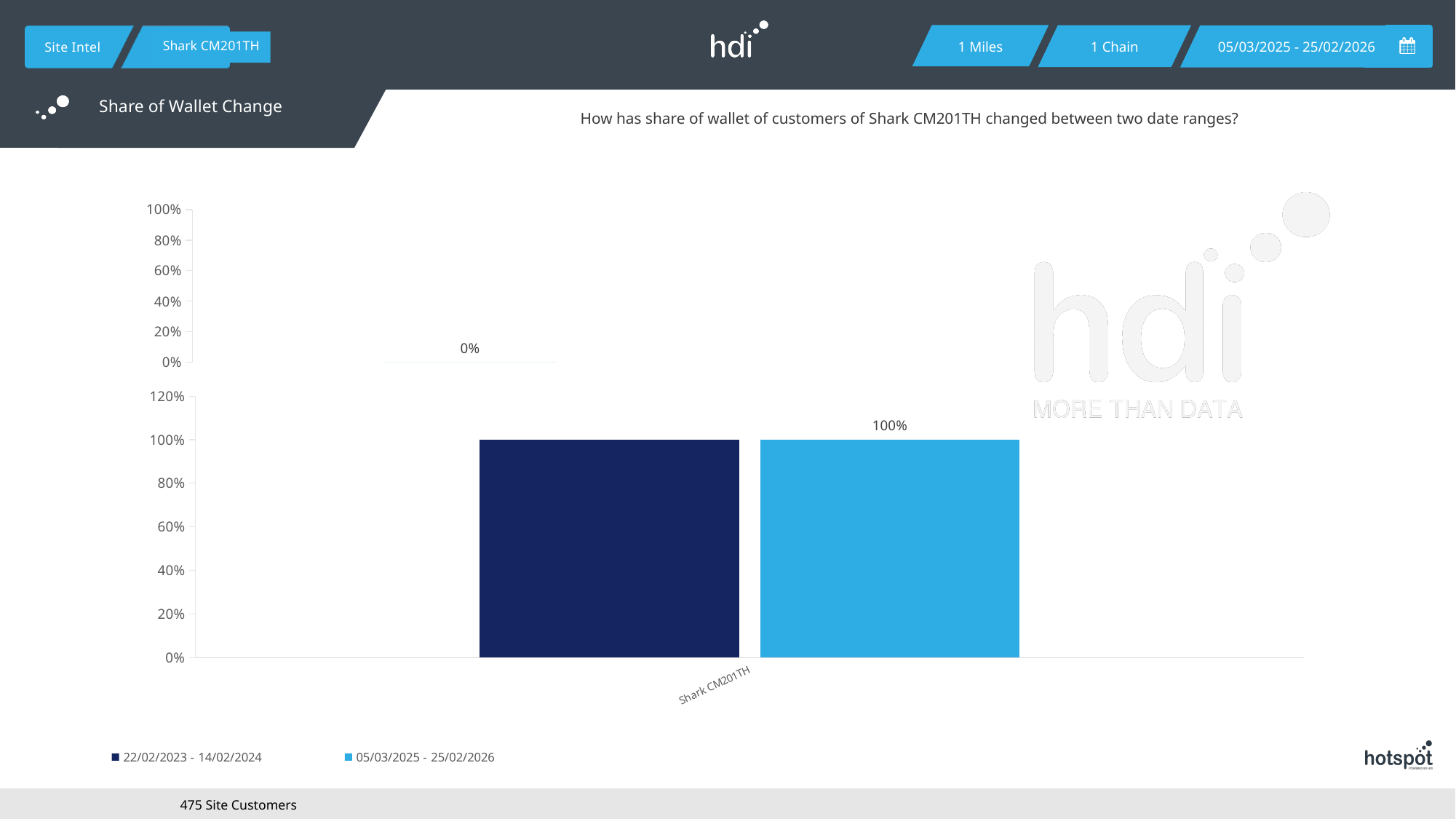
How many series does the legend of the bottom bar chart list? 2 How many categories are shown on the x axis of the bottom bar chart? 1 In the bottom bar chart, what is the value for Shark CM201TH in the 05/03/2025 - 25/02/2026 series? 100% In the bottom bar chart, is the value for the 05/03/2025 - 25/02/2026 series greater or less than 120%? less What kind of chart is the bottom chart on the slide? bar chart What is the name of the category on the x axis of the bottom bar chart? Shark CM201TH In the bottom bar chart, is the value for the 22/02/2023 - 14/02/2024 series greater or less than 80%? greater In the top chart, what value is printed as the data label? 0% What is the highest tick value on the y axis of the bottom bar chart? 120% In the bottom bar chart, which series is shown in dark navy? 22/02/2023 - 14/02/2024